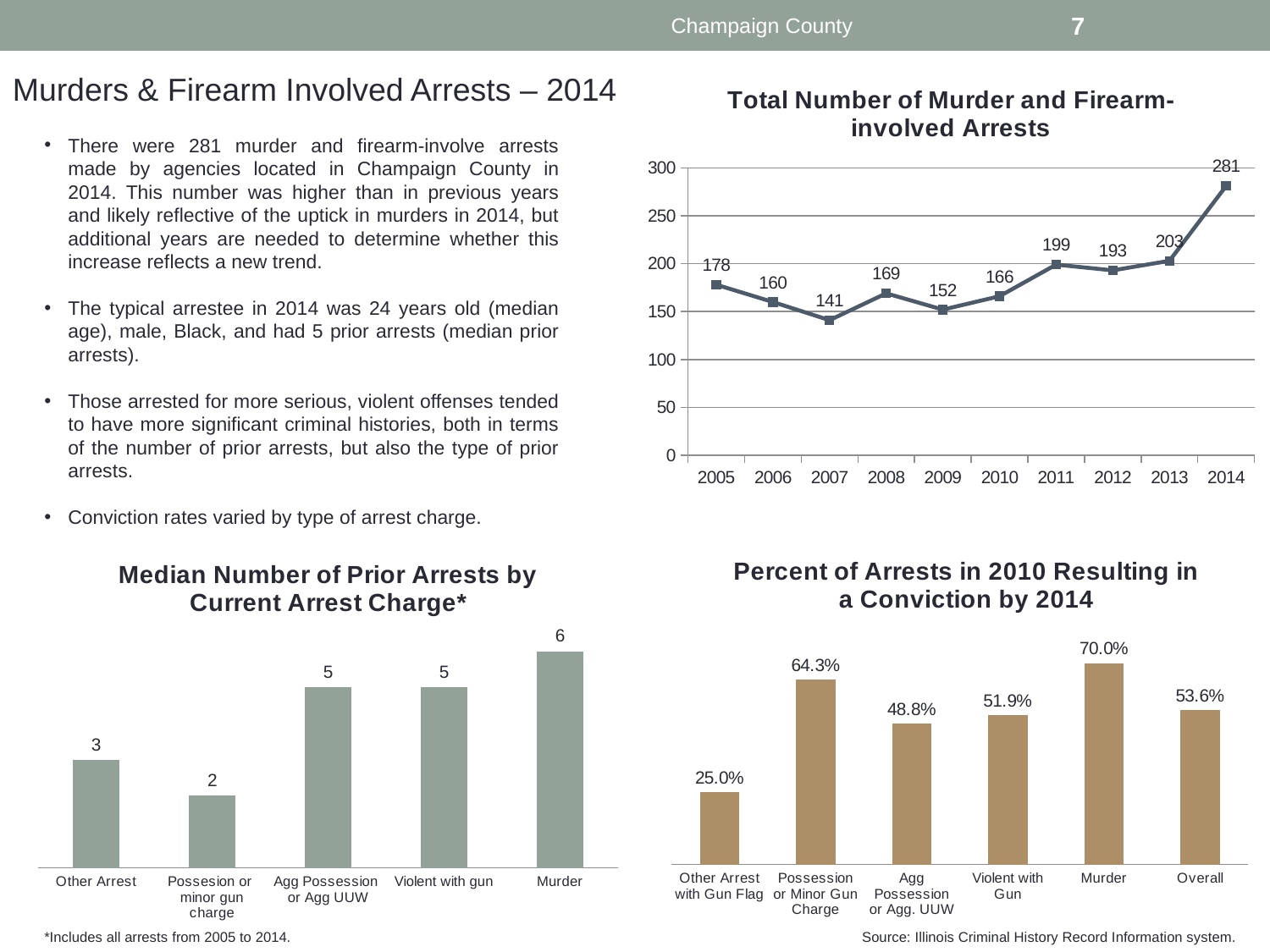
In the 'Median Number of Prior Arrests by Current Arrest Charge' chart, what is the value for Murder? 6 What kind of chart is 'Total Number of Murder and Firearm-involved Arrests'? Line chart In the 'Total Number of Murder and Firearm-involved Arrests' chart, which year has the lowest value? 2007 In the 'Percent of Arrests in 2010 Resulting in a Conviction by 2014' chart, what is the value for Murder? 70.0% In the 'Total Number of Murder and Firearm-involved Arrests' chart, how many years are plotted? 10 In the 'Total Number of Murder and Firearm-involved Arrests' chart, what is the value for 2014? 281 What kind of chart is 'Percent of Arrests in 2010 Resulting in a Conviction by 2014'? Bar chart In the 'Median Number of Prior Arrests by Current Arrest Charge' chart, how many categories are shown? 5 In the 'Percent of Arrests in 2010 Resulting in a Conviction by 2014' chart, which is larger: Possession or Minor Gun Charge or Overall? Possession or Minor Gun Charge In the 'Median Number of Prior Arrests by Current Arrest Charge' chart, which category has the lowest value? Possesion or minor gun charge In the 'Percent of Arrests in 2010 Resulting in a Conviction by 2014' chart, which category has the lowest value? Other Arrest with Gun Flag In the 'Total Number of Murder and Firearm-involved Arrests' chart, what is the difference between the 2014 and 2013 values? 78